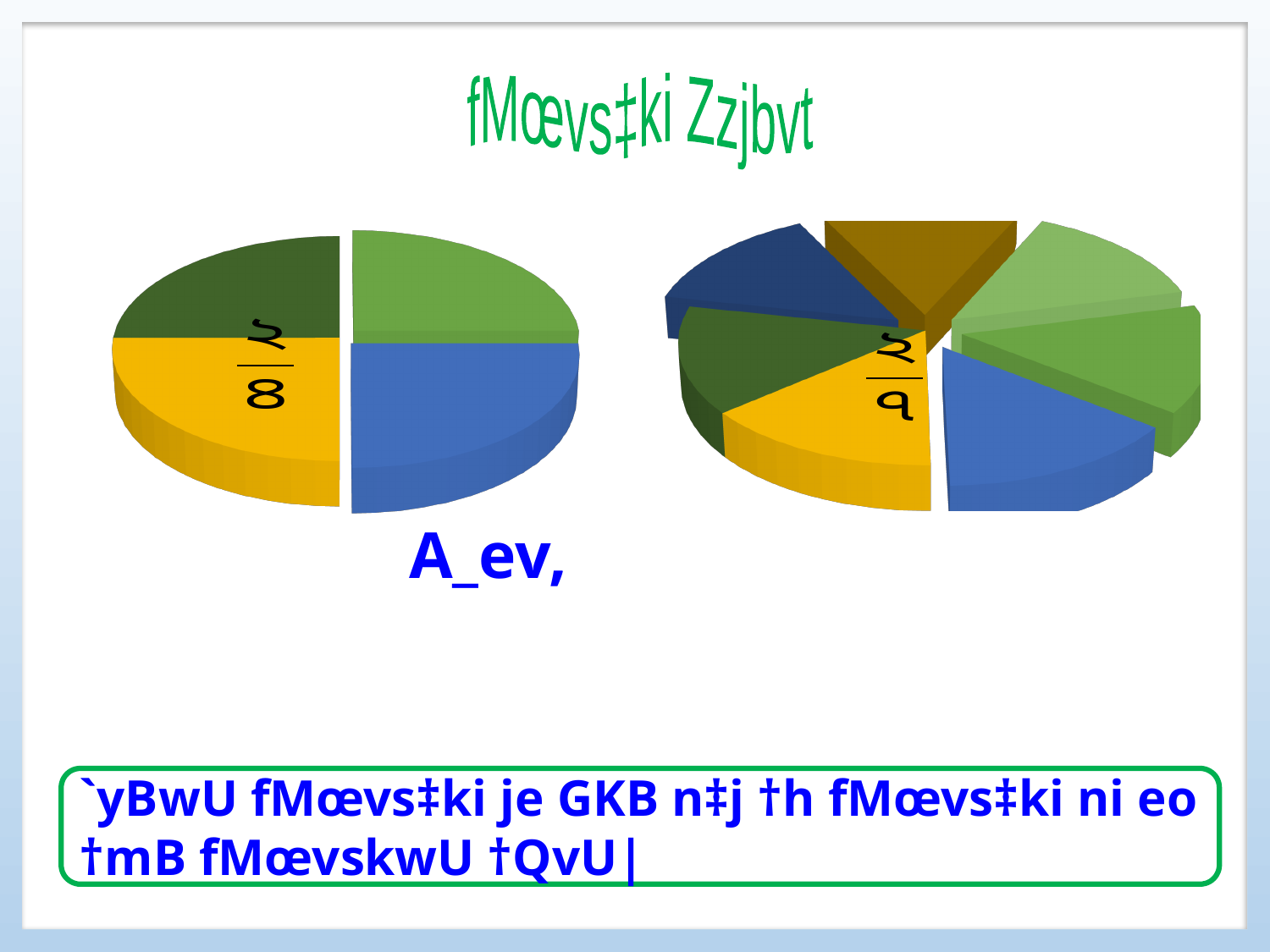
In the pie chart on the left of the slide, what share of the pie does each slice represent, according to the printed label? ১/৪ What kind of chart is the chart on the left of the slide? pie chart How many charts are shown on the slide? 2 What fraction label is printed on the pie chart on the left of the slide? ১/৪ Which pie chart has more slices, the one on the left or the one on the right? the one on the right In the pie chart on the right of the slide, what share of the pie does each slice represent, according to the printed label? ১/৭ In the pie chart on the left of the slide, what colour is the slice at the bottom right? blue How many slices does the pie chart on the left of the slide have? 4 What kind of chart is the chart on the right of the slide? pie chart In the pie chart on the right of the slide, what colour is the slice at the top centre? brown How many slices does the pie chart on the right of the slide have? 7 What fraction label is printed on the pie chart on the right of the slide? ১/৭